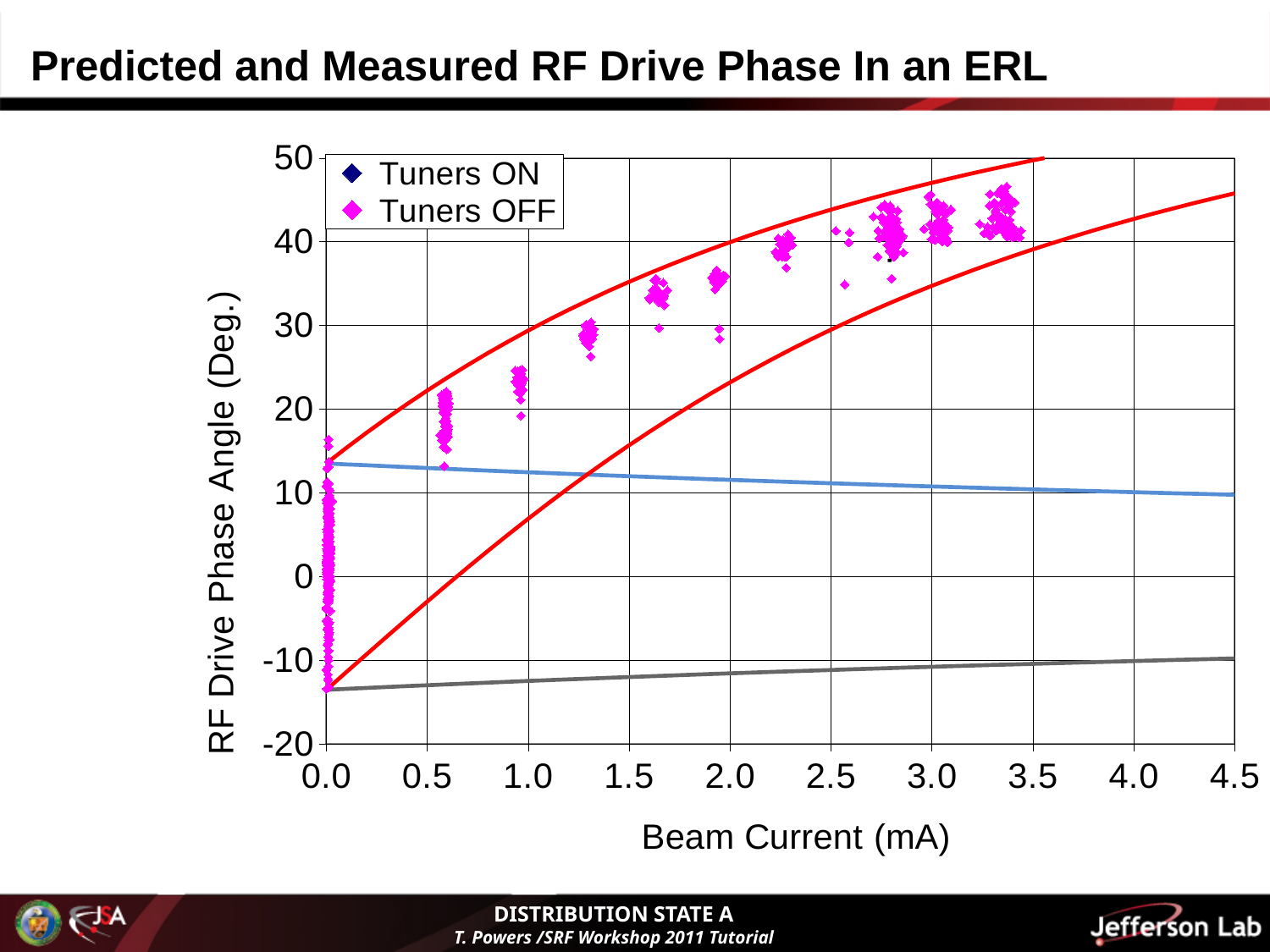
Is the value of the gray line at 0.0 mA greater or less than -10 degrees? less Do the Tuners OFF data points rise or fall as beam current increases? rise Does the blue line rise or fall as beam current increases from 0.0 to 4.5 mA? fall Are the Tuners OFF values near 1.0 mA greater or less than 10 degrees? greater Is the value of the blue line at 0.0 mA greater or less than 10 degrees? greater What kind of chart is shown on the slide? scatter chart Does the gray line rise or fall as beam current increases from 0.0 to 4.5 mA? rise What is the label of the x axis? Beam Current (mA) What is the highest value shown on the y axis? 50 How many series does the legend list? 2 What is the title of the chart? Predicted and Measured RF Drive Phase In an ERL